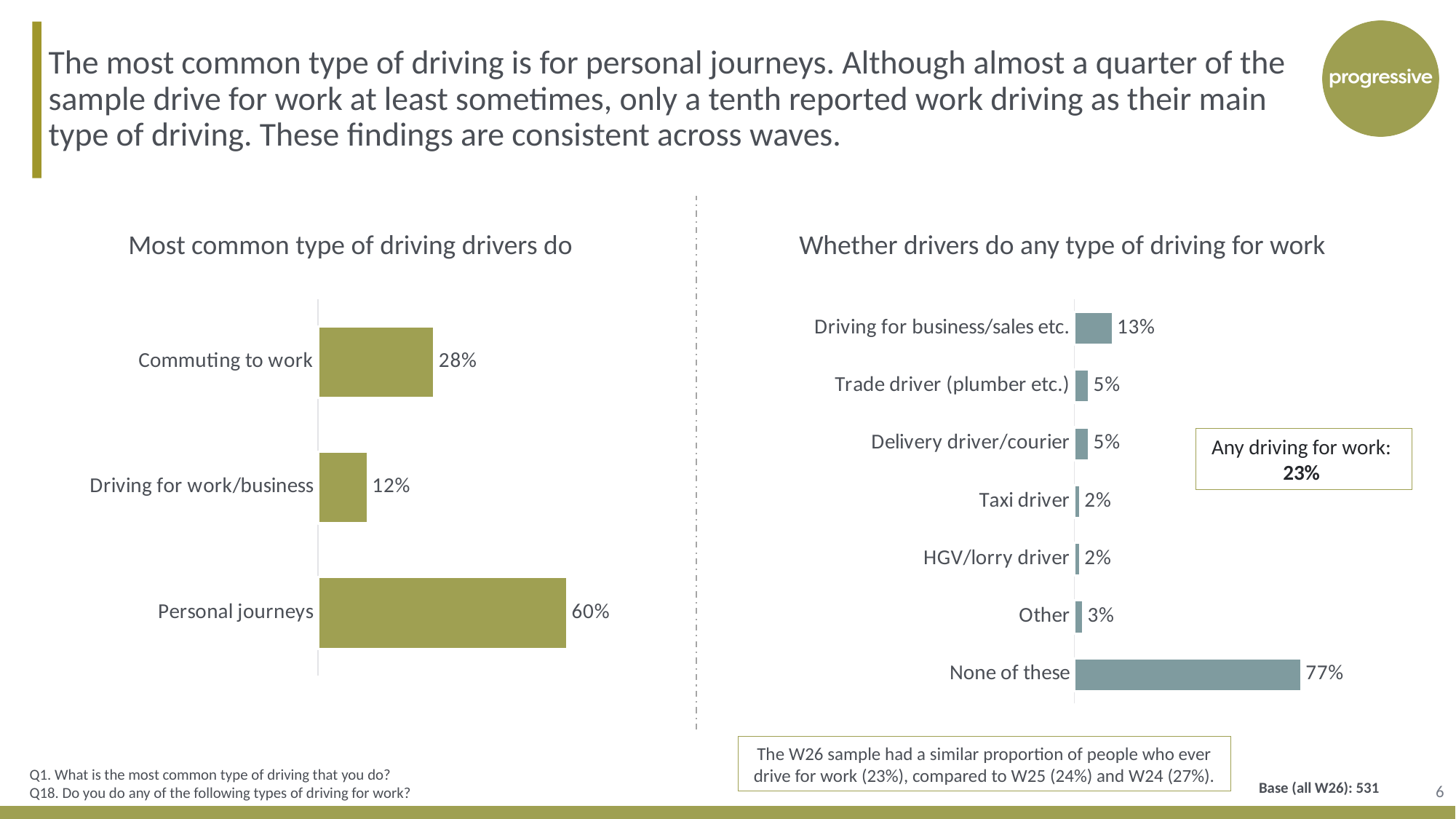
In the 'Whether drivers do any type of driving for work' chart, what is the difference between None of these and Driving for business/sales etc.? 64 percentage points In the 'Whether drivers do any type of driving for work' chart, what is the value for Driving for business/sales etc.? 13% What type of chart is the 'Most common type of driving drivers do' chart? Bar chart In the 'Most common type of driving drivers do' chart, what is the difference between Personal journeys and Commuting to work? 32 percentage points In the 'Whether drivers do any type of driving for work' chart, what is the value for None of these? 77% In the 'Most common type of driving drivers do' chart, what is the value for Commuting to work? 28% In the 'Most common type of driving drivers do' chart, what is the value for Personal journeys? 60% In the 'Whether drivers do any type of driving for work' chart, which category has the highest value? None of these In the 'Whether drivers do any type of driving for work' chart, how many categories are shown? 7 In the 'Most common type of driving drivers do' chart, which category has the lowest value? Driving for work/business In the 'Whether drivers do any type of driving for work' chart, which is larger: Driving for business/sales etc. or Trade driver (plumber etc.)? Driving for business/sales etc. In the 'Most common type of driving drivers do' chart, how many categories are shown? 3